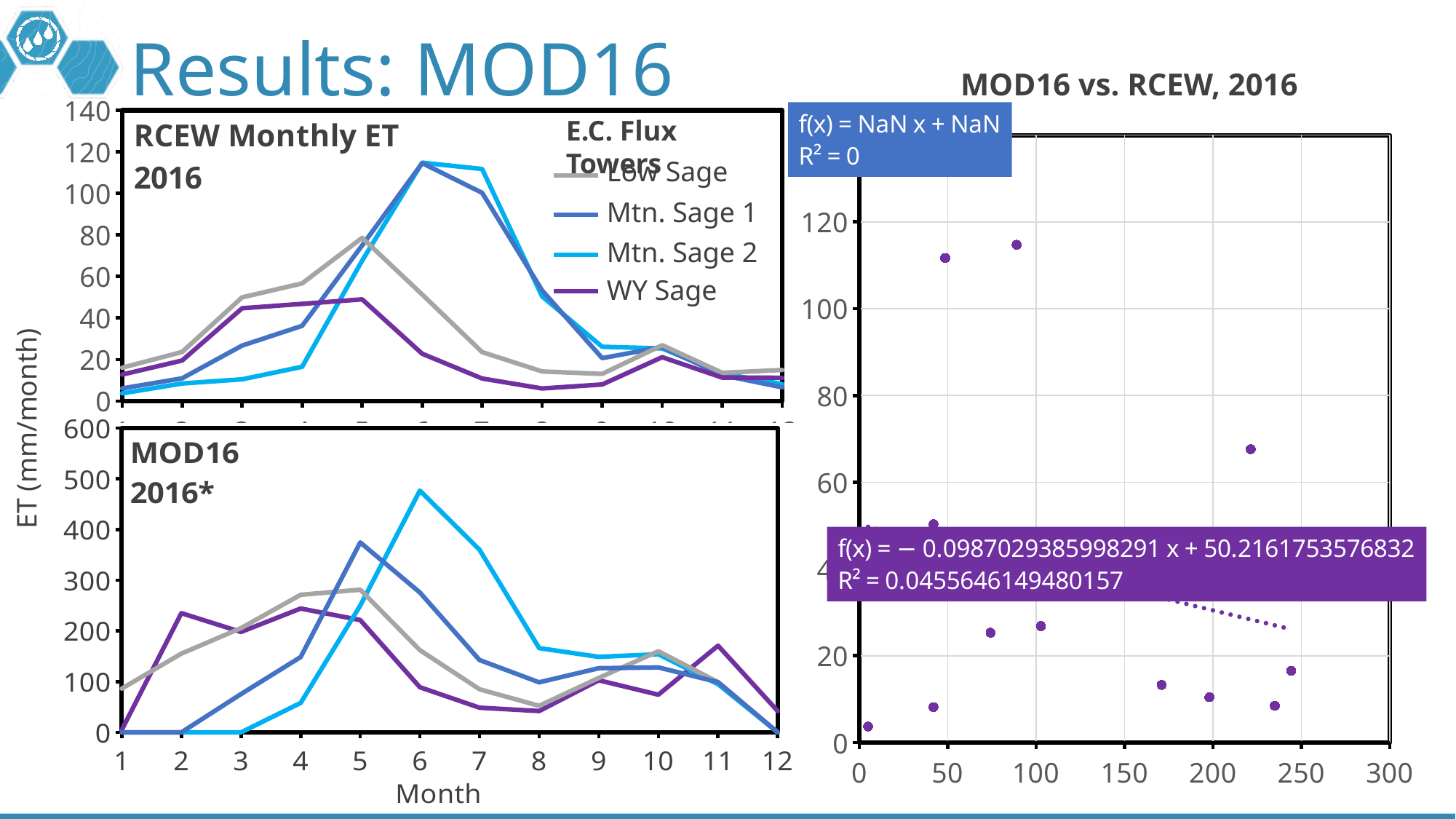
In the 'RCEW Monthly ET 2016' chart, does the Low Sage line rise or fall from month 5 to month 8? fall In the 'RCEW Monthly ET 2016' chart, is the value for Mtn. Sage 2 in month 6 greater or less than 100? greater What type of chart is the 'MOD16 vs. RCEW, 2016' chart on the right of the slide? scatter chart What is the y-axis label shared by the two line charts on the left? ET (mm/month) In the 'MOD16 2016*' chart, is the value for Mtn. Sage 2 in month 6 greater or less than 400? greater What type of chart is the 'RCEW Monthly ET 2016' chart at the top left? line chart In the 'RCEW Monthly ET 2016' chart, which series has the lowest peak value? WY Sage In the 'MOD16 2016*' chart, which series reaches the highest value? Mtn. Sage 2 In the 'RCEW Monthly ET 2016' chart, is the value for Low Sage in month 5 greater or less than 60? greater How many months are shown along the x axis of the 'MOD16 2016*' chart? 12 How many series does the 'E.C. Flux Towers' legend list for the line charts? 4